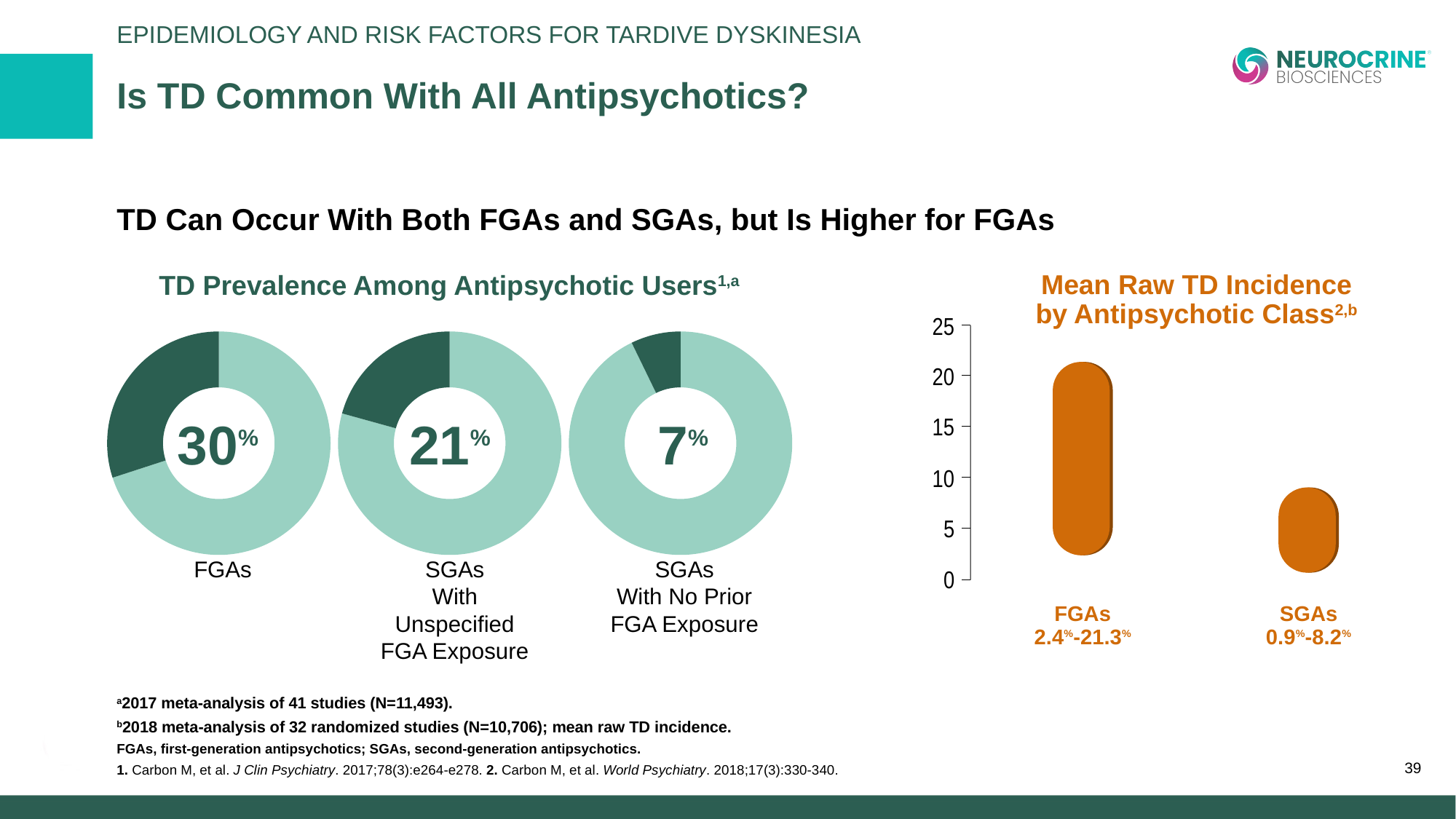
In the Mean Raw TD Incidence by Antipsychotic Class chart, what is the incidence range shown for FGAs? 2.4%-21.3% In the Mean Raw TD Incidence by Antipsychotic Class chart, is the top of the FGAs bar greater or less than 20? greater In the TD Prevalence Among Antipsychotic Users chart, what is the TD prevalence for FGAs? 30% In the TD Prevalence Among Antipsychotic Users chart, which group has the lowest TD prevalence? SGAs With No Prior FGA Exposure In the TD Prevalence Among Antipsychotic Users chart, what is the TD prevalence for SGAs With Unspecified FGA Exposure? 21% In the Mean Raw TD Incidence by Antipsychotic Class chart, which class has the higher upper end of its incidence range, FGAs or SGAs? FGAs In the TD Prevalence Among Antipsychotic Users chart, what is the TD prevalence for SGAs With No Prior FGA Exposure? 7% In the TD Prevalence Among Antipsychotic Users chart, how many percentage points higher is the prevalence for FGAs than for SGAs With No Prior FGA Exposure? 23 In the Mean Raw TD Incidence by Antipsychotic Class chart, what is the incidence range shown for SGAs? 0.9%-8.2% What kind of chart is used for the TD Prevalence Among Antipsychotic Users chart? Donut chart In the TD Prevalence Among Antipsychotic Users chart, which group has the highest TD prevalence? FGAs How many donut charts are shown in the TD Prevalence Among Antipsychotic Users chart? 3